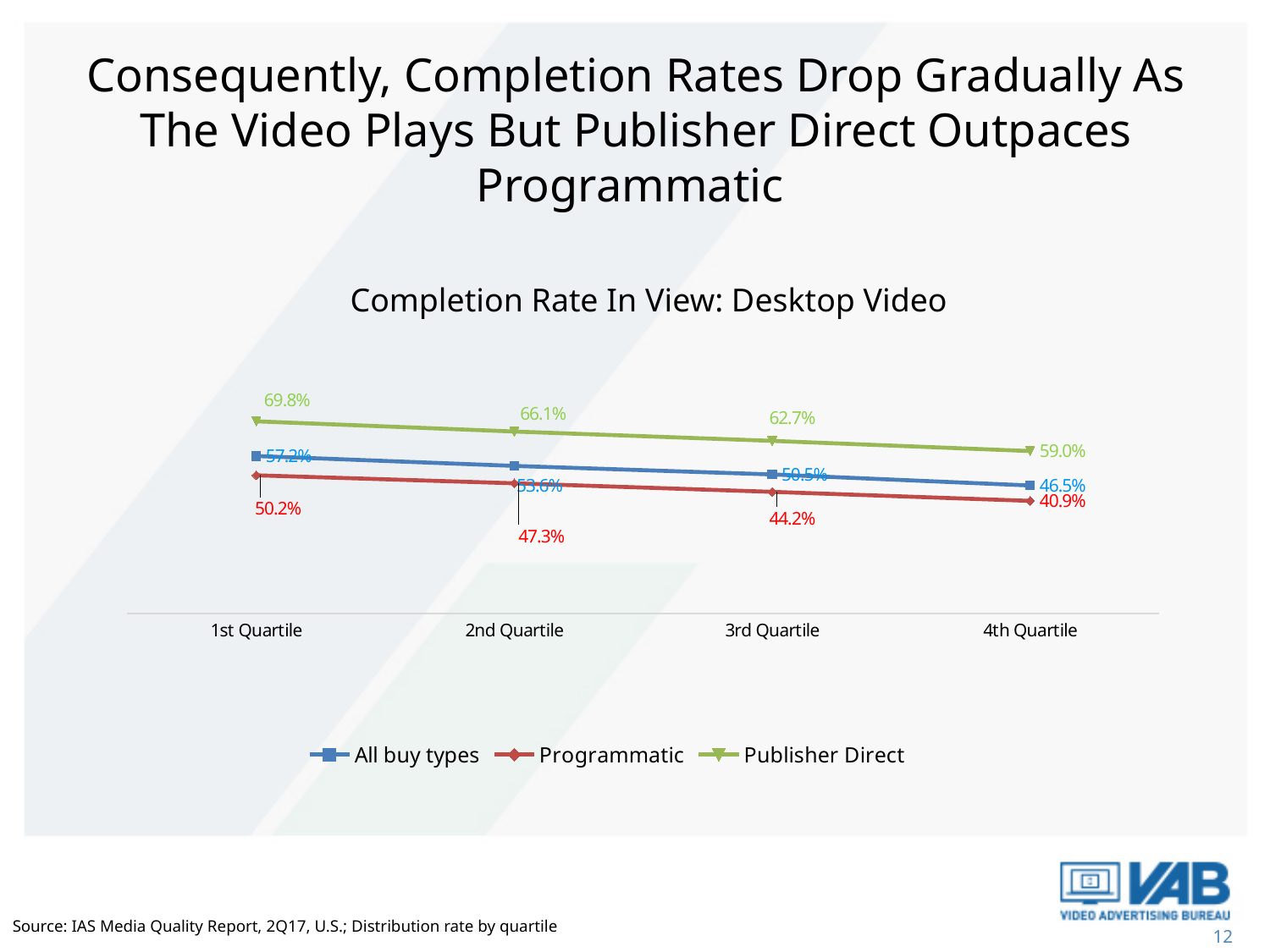
What is the All buy types completion rate in the 4th Quartile? 46.5% What kind of chart is shown on the slide? Line chart How many quartile categories are shown on the x axis? 4 What is the Programmatic completion rate in the 4th Quartile? 40.9% What is the Publisher Direct completion rate in the 3rd Quartile? 62.7% By how many percentage points does the Publisher Direct completion rate fall from the 1st Quartile to the 4th Quartile? 10.8 percentage points In which quartile is the Programmatic completion rate lowest? 4th Quartile What is the title of the chart? Completion Rate In View: Desktop Video What is the Publisher Direct completion rate in the 1st Quartile? 69.8% Does the Programmatic completion rate rise or fall from the 1st Quartile to the 4th Quartile? Fall How many series does the legend list? 3 Which series has the highest completion rate in the 4th Quartile? Publisher Direct